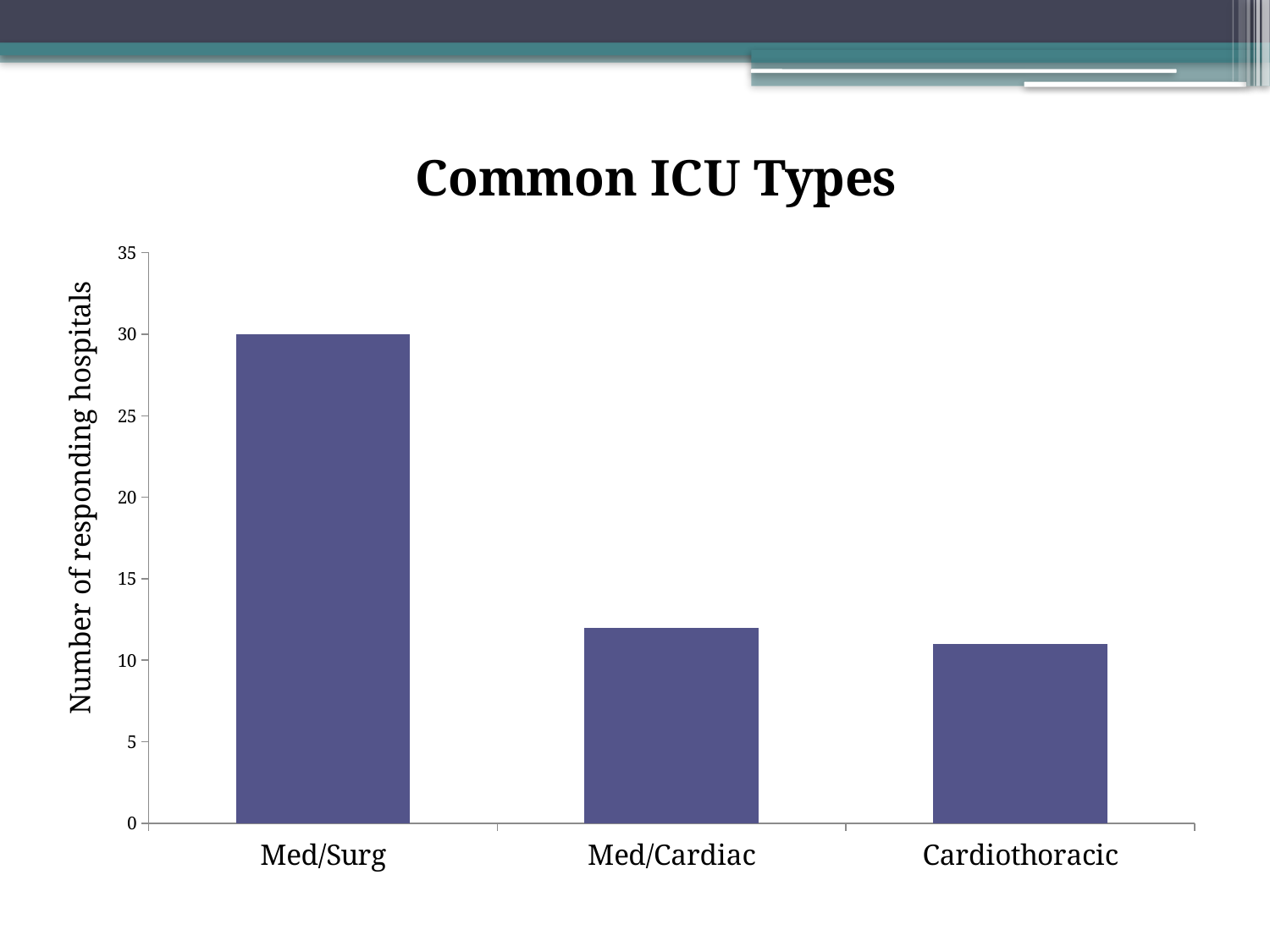
What is the label on the vertical axis of the chart? Number of responding hospitals Which has more responding hospitals, Med/Surg or Med/Cardiac? Med/Surg Which ICU type has the highest number of responding hospitals? Med/Surg How many responding hospitals are shown for Med/Surg? 30 What is the title of the chart? Common ICU Types Do the bar values rise or fall from left to right across the chart? Fall Is the value for Med/Cardiac greater or less than 15? less Which has more responding hospitals, Med/Surg or Cardiothoracic? Med/Surg Is the value for Med/Cardiac greater or less than 10? greater How many ICU types are shown on the chart? 3 What type of chart is shown on the slide? Bar chart Is the value for Cardiothoracic greater or less than 15? less